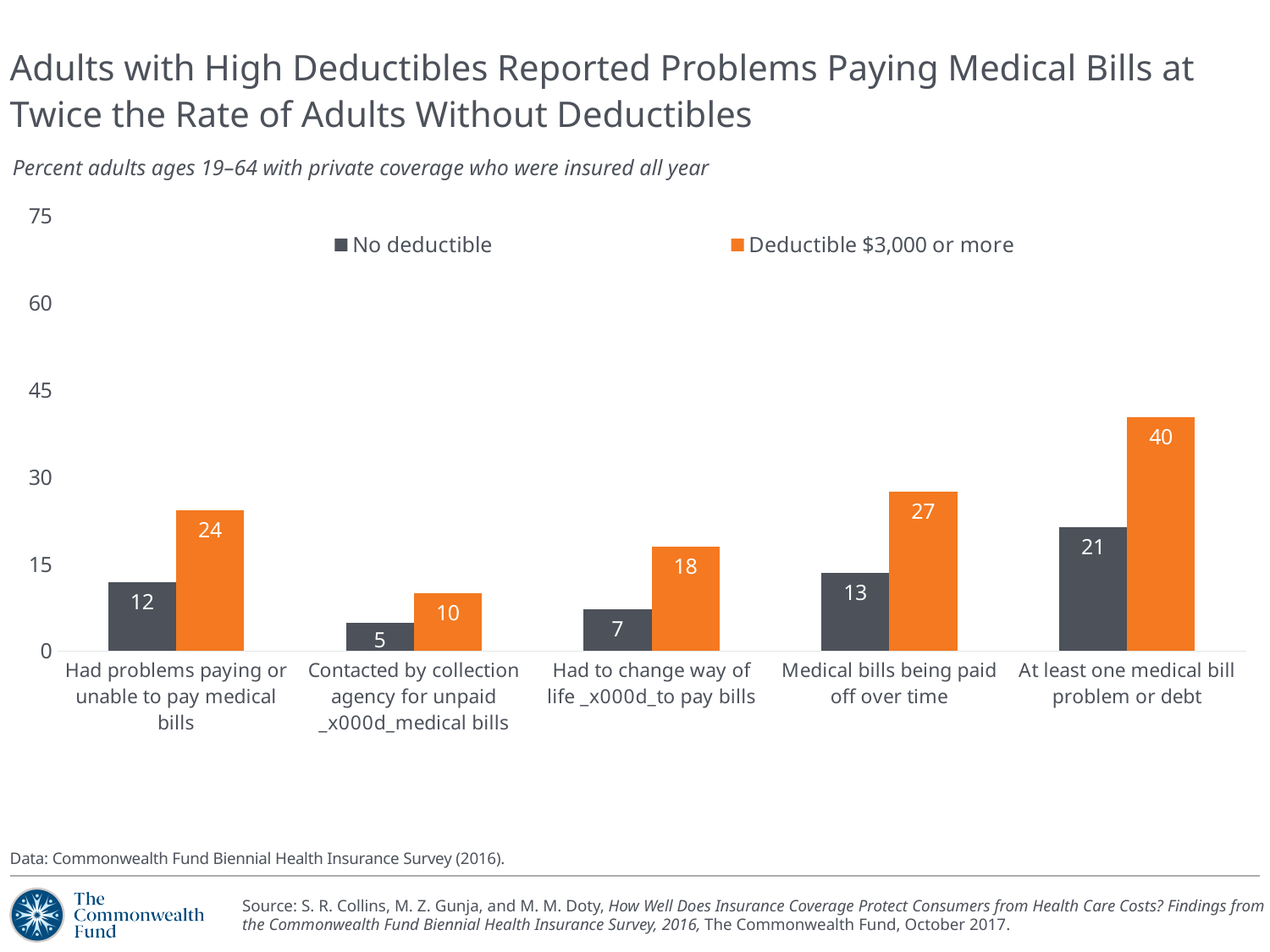
Which category has the highest value for "Deductible $3,000 or more"? At least one medical bill problem or debt What kind of chart is shown on the slide? Bar chart What is the value for "Deductible $3,000 or more" in the "At least one medical bill problem or debt" category? 40 How many categories are shown on the x axis? 5 What colour are the bars for the "Deductible $3,000 or more" series? Orange What is the value for "Deductible $3,000 or more" in the "Had to change way of life to pay bills" category? 18 How many series does the legend list? 2 What is the difference between the "Deductible $3,000 or more" and "No deductible" values in the "Medical bills being paid off over time" category? 14 In the "Had problems paying or unable to pay medical bills" category, which series has the larger value? Deductible $3,000 or more Which category has the lowest value for "No deductible"? Contacted by collection agency for unpaid medical bills What is the value for "No deductible" in the "Had problems paying or unable to pay medical bills" category? 12 What is the value for "No deductible" in the "Contacted by collection agency for unpaid medical bills" category? 5